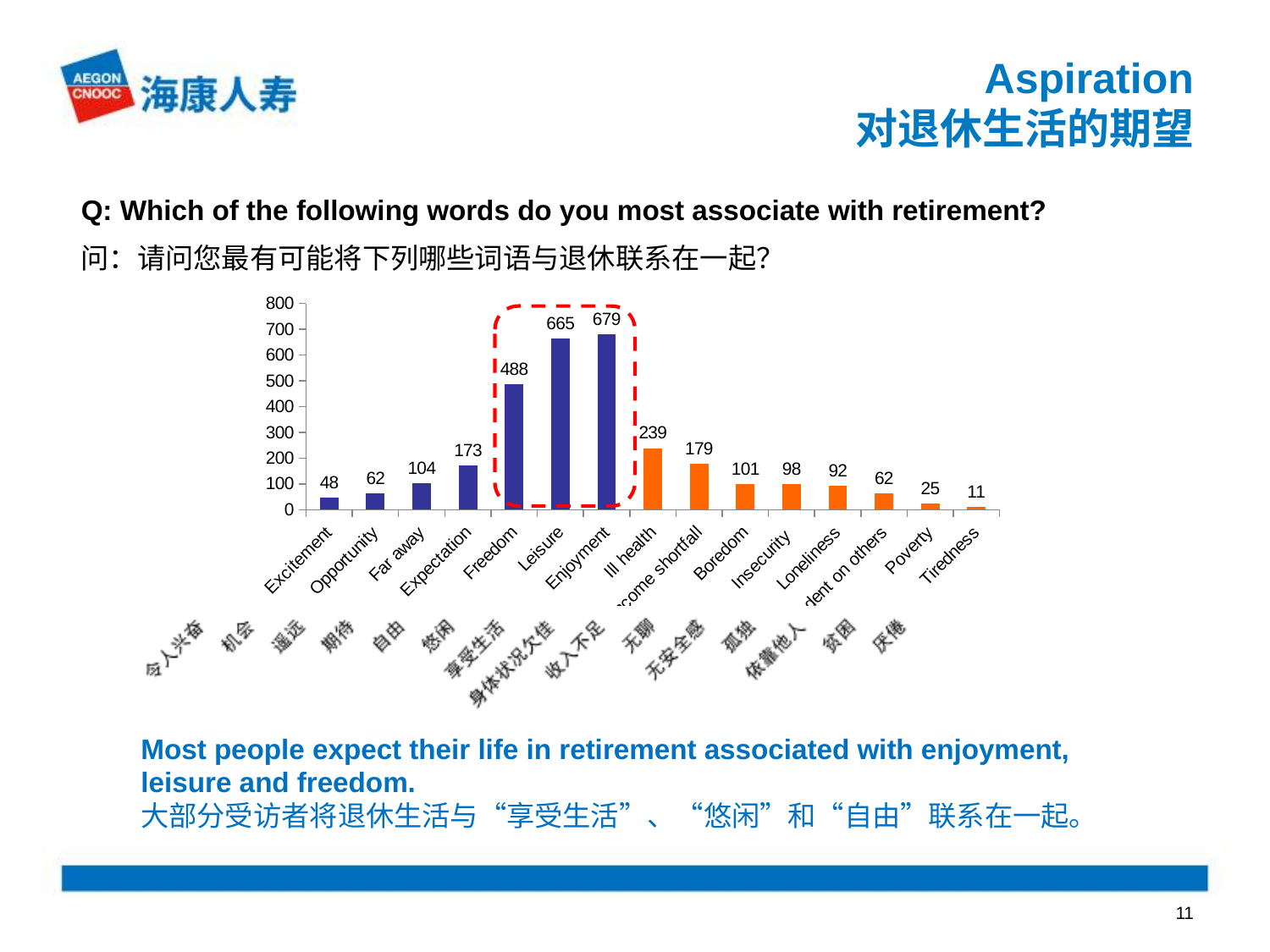
What is the value for Ill health? 239 Which three categories are enclosed by the red dashed box? Freedom, Leisure and Enjoyment What kind of chart is shown on the slide? Bar chart Is the value for Leisure greater or less than 600? greater Which category has the lowest value? Tiredness What is the difference between the values for Freedom and Ill health? 249 What is the value for Freedom? 488 What is the value for Excitement? 48 Which category has the highest value? Enjoyment Which is larger, the value for Expectation or the value for Boredom? Expectation What is the difference between the values for Enjoyment and Leisure? 14 How many categories are shown on the x axis? 15